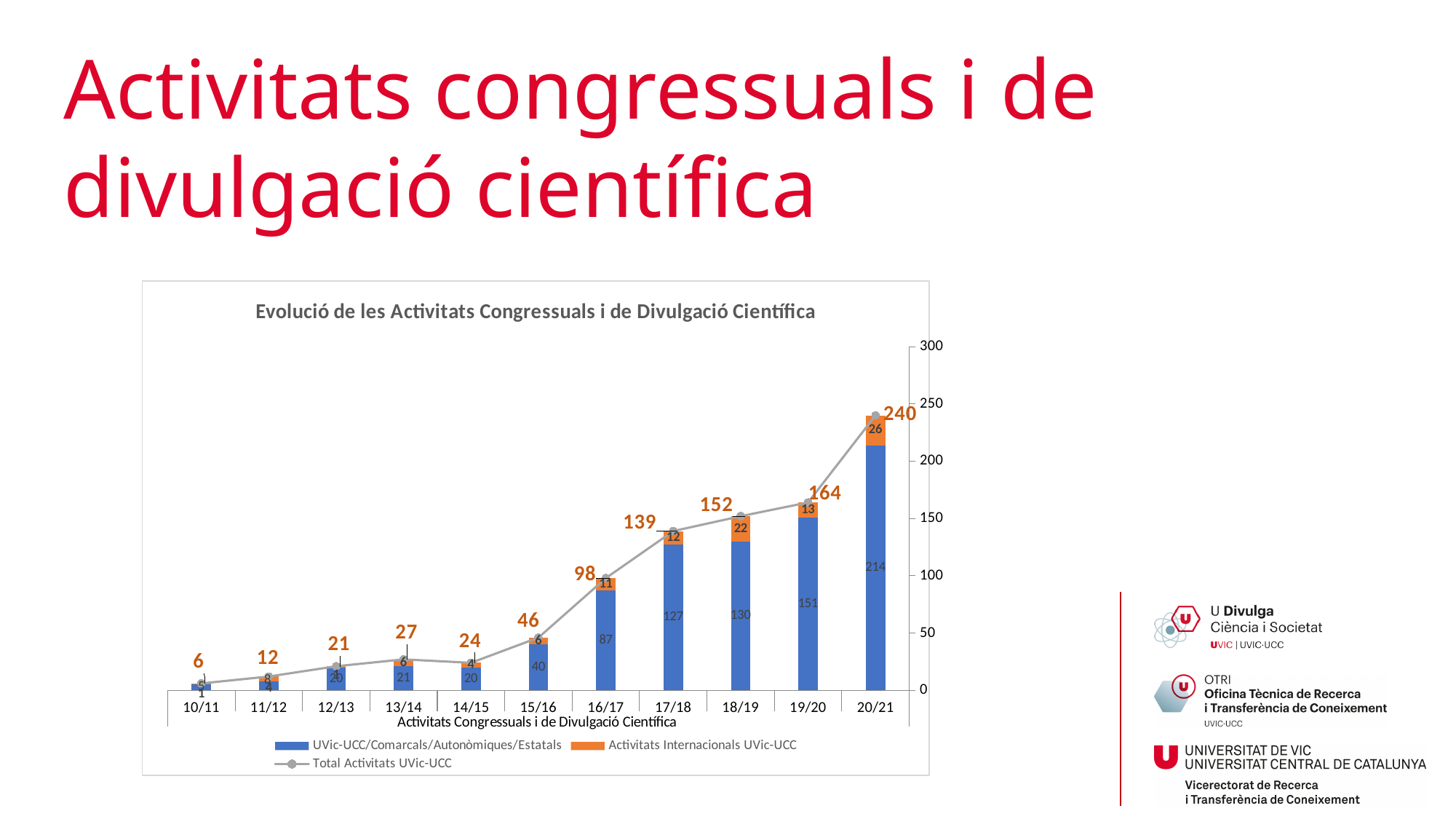
What is the difference between the total activities in 20/21 and 19/20? 76 What is the total number of activities (Total Activitats UVic-UCC) for 20/21? 240 What is the title of the chart? Evolució de les Activitats Congressuals i de Divulgació Científica What is the value of UVic-UCC/Comarcals/Autonòmiques/Estatals for 17/18? 127 How many academic years are shown on the x axis? 11 What is the value of Activitats Internacionals UVic-UCC for 18/19? 22 Which year has more international activities (Activitats Internacionals UVic-UCC), 18/19 or 19/20? 18/19 Which academic year has the lowest total of activities? 10/11 What is the total number of activities for 16/17? 98 Is the value of UVic-UCC/Comarcals/Autonòmiques/Estatals for 20/21 greater or less than 200? greater How many series does the legend list? 3 Which academic year has the highest total of activities? 20/21